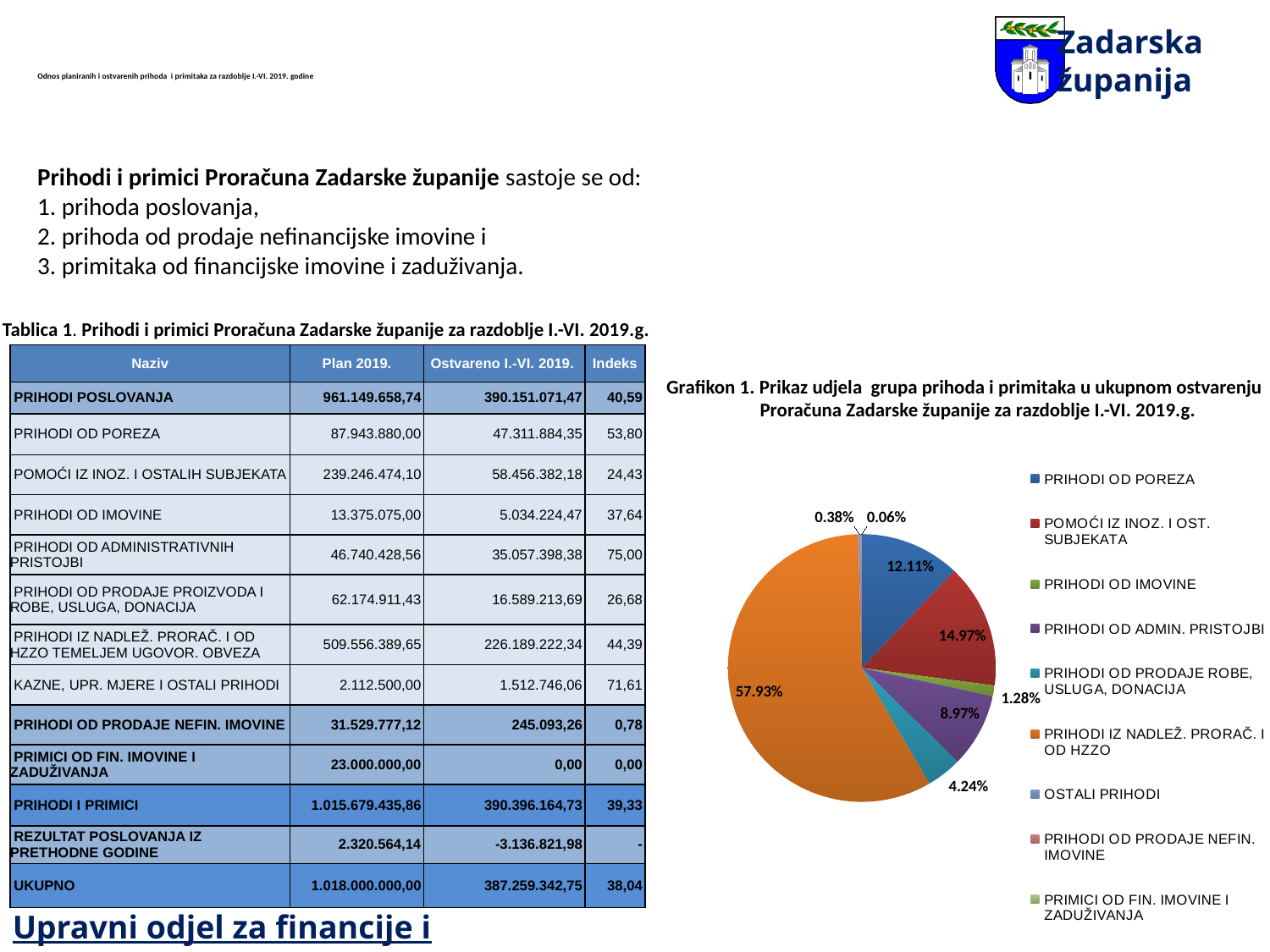
In Grafikon 1, what share does PRIHODI IZ NADLEŽ. PRORAČ. I OD HZZO have? 57.93% How many categories does the legend of Grafikon 1 list? 9 In Grafikon 1, by how many percentage points does the share of PRIHODI IZ NADLEŽ. PRORAČ. I OD HZZO exceed the share of POMOĆI IZ INOZ. I OST. SUBJEKATA? 42.96 percentage points What kind of chart is Grafikon 1 on the slide? Pie chart In Grafikon 1, what share does PRIHODI OD ADMIN. PRISTOJBI have? 8.97% In Grafikon 1, what share does PRIHODI OD POREZA have? 12.11% In Grafikon 1, what share does PRIHODI OD PRODAJE ROBE, USLUGA, DONACIJA have? 4.24% In Grafikon 1, which is larger: the share of PRIHODI OD POREZA or the share of POMOĆI IZ INOZ. I OST. SUBJEKATA? POMOĆI IZ INOZ. I OST. SUBJEKATA In Grafikon 1, what share does POMOĆI IZ INOZ. I OST. SUBJEKATA have? 14.97% In Grafikon 1, what share does PRIHODI OD IMOVINE have? 1.28% In Grafikon 1, which category has the largest slice of the pie? PRIHODI IZ NADLEŽ. PRORAČ. I OD HZZO In Grafikon 1, what colour is the largest slice of the pie? Orange